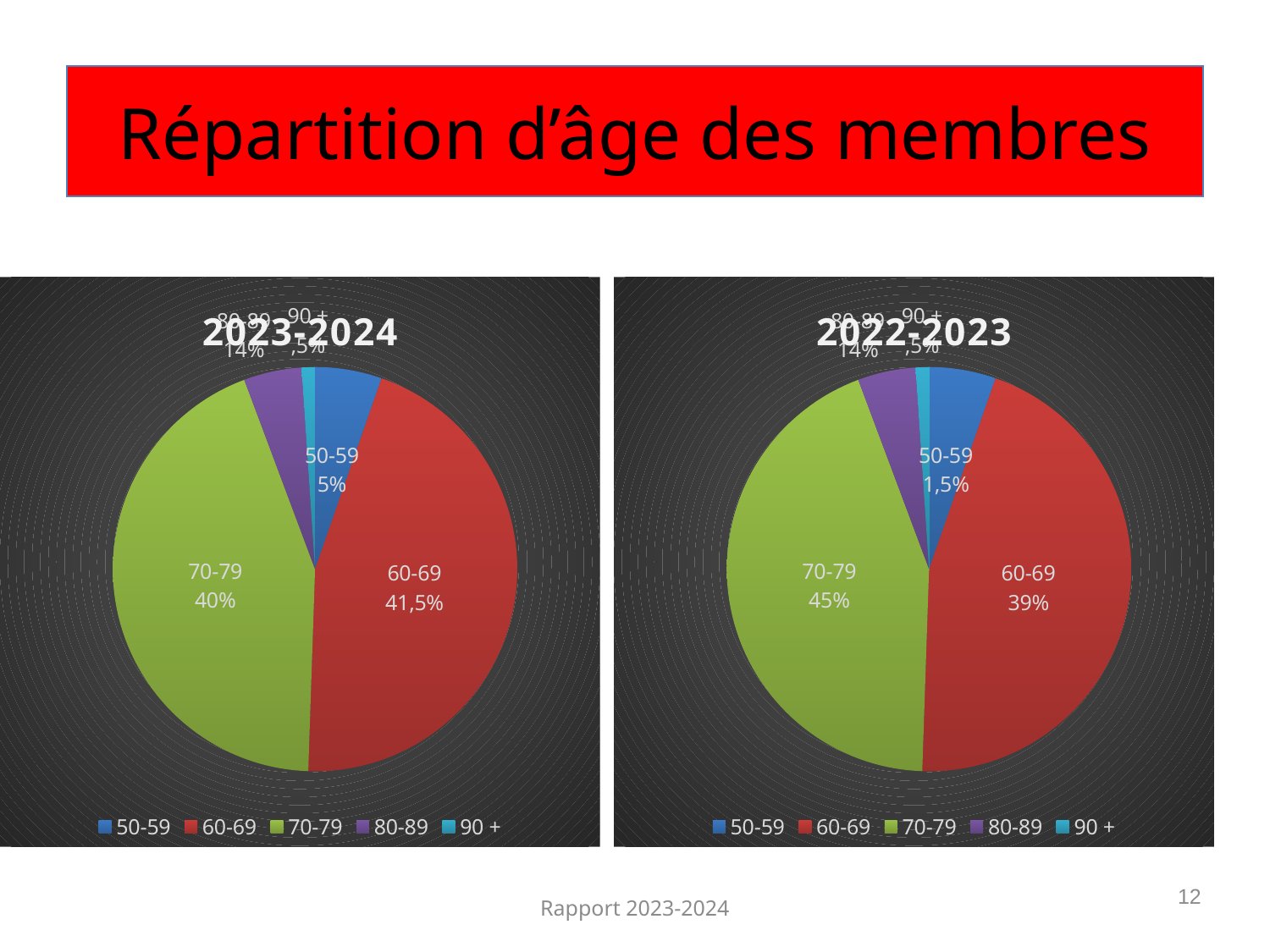
In the 2022-2023 chart, what share do members aged 70-79 represent? 45% In the 2023-2024 chart, what share do members aged 50-59 represent? 5% In the 2023-2024 chart, what is the difference between the shares of the 60-69 and 70-79 age groups? 1,5% In the 2023-2024 chart, what share do members aged 70-79 represent? 40% What kind of chart is the 2023-2024 chart? pie chart In the 2023-2024 chart, what share do members aged 60-69 represent? 41,5% In the 2022-2023 chart, what share do members aged 50-59 represent? 1,5% In the 2022-2023 chart, what share do members aged 60-69 represent? 39% In the 2022-2023 chart, which age group has the largest share? 70-79 Which chart shows a larger share for the 50-59 age group, 2023-2024 or 2022-2023? 2023-2024 In the 2022-2023 chart, what is the difference between the shares of the 70-79 and 60-69 age groups? 6% How many age groups does the legend of the 2023-2024 chart list? 5